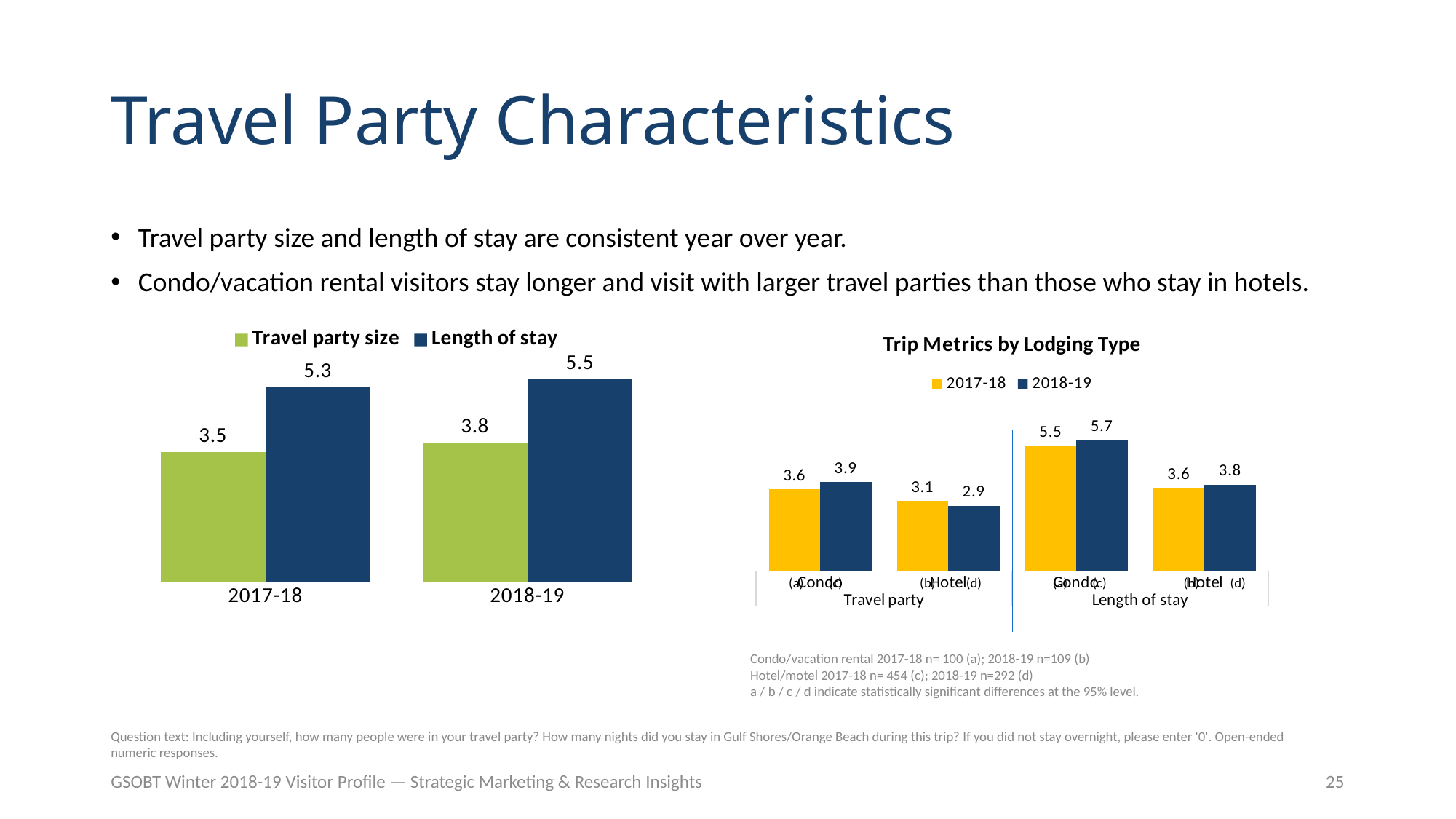
In the left chart, does Length of stay rise or fall from 2017-18 to 2018-19? rise In the left chart, what is the Length of stay for 2018-19? 5.5 In the Trip Metrics by Lodging Type chart, what is the 2018-19 Travel party value for Condo? 3.9 In the left chart, how many series does the legend list? 2 In the left chart, what is the difference between Length of stay and Travel party size in 2017-18? 1.8 In the left chart, which year has the larger Travel party size, 2017-18 or 2018-19? 2018-19 In the left chart, what is the Travel party size for 2017-18? 3.5 What type of chart is the Trip Metrics by Lodging Type chart? bar chart In the Trip Metrics by Lodging Type chart, which bar is the highest? 2018-19 Length of stay for Condo (5.7) In the Trip Metrics by Lodging Type chart, what is the 2017-18 Length of stay value for Hotel? 3.6 In the Trip Metrics by Lodging Type chart, what is the difference between the 2018-19 Length of stay for Condo and for Hotel? 1.9 In the Trip Metrics by Lodging Type chart, which bar is the lowest? 2018-19 Travel party for Hotel (2.9)